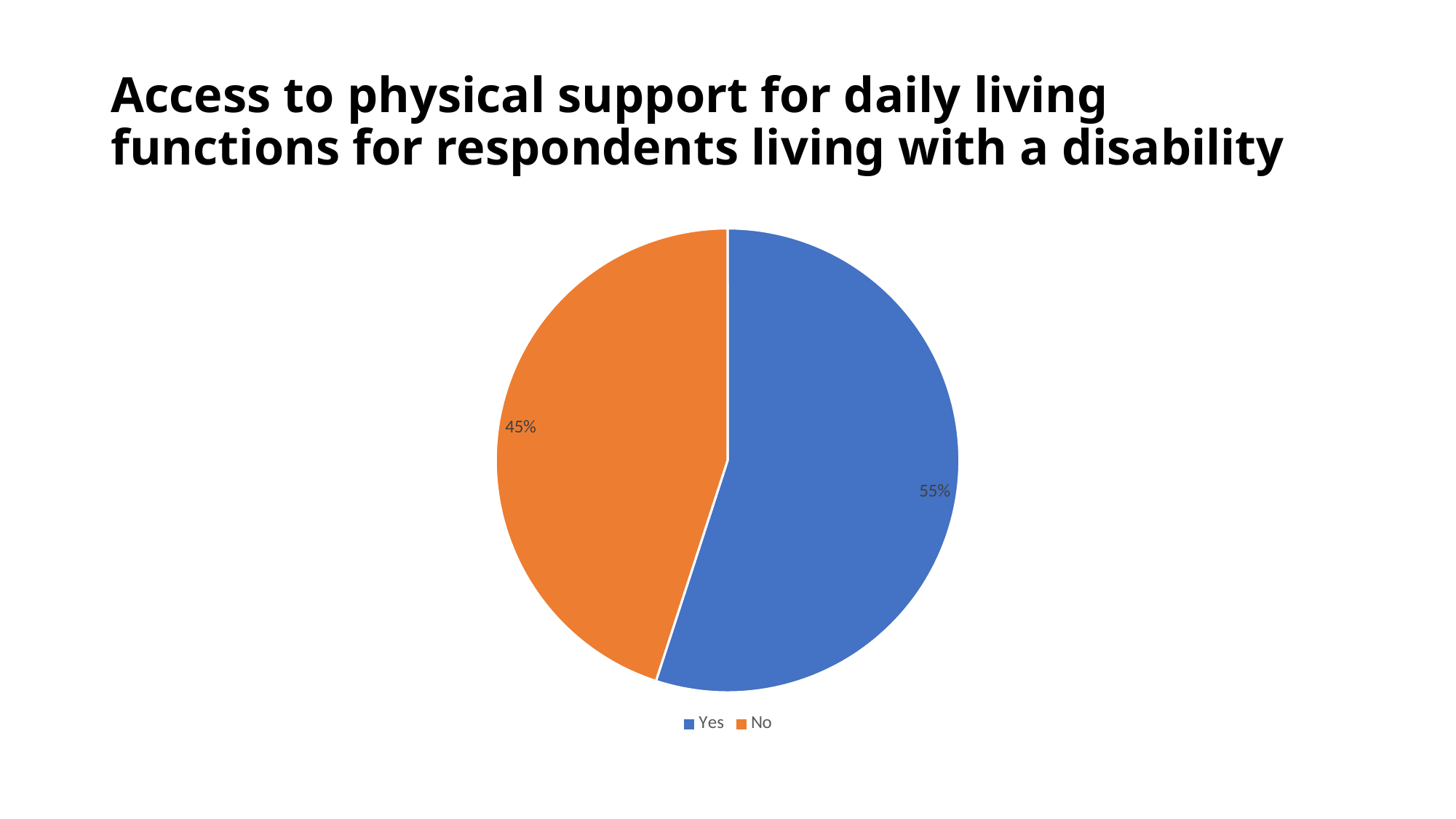
What colour is the No slice? orange What share of respondents answered No? 45% How many entries does the legend list? 2 How many categories does the pie chart show? 2 What kind of chart is shown on the slide? pie chart Which slice is larger, Yes or No? Yes What share of respondents answered Yes? 55% Which category has the smallest slice of the pie? No Which category has the largest slice of the pie? Yes Is the share for Yes greater or less than 50%? greater What colour is the Yes slice? blue What is the difference in percentage points between the Yes and No slices? 10 percentage points